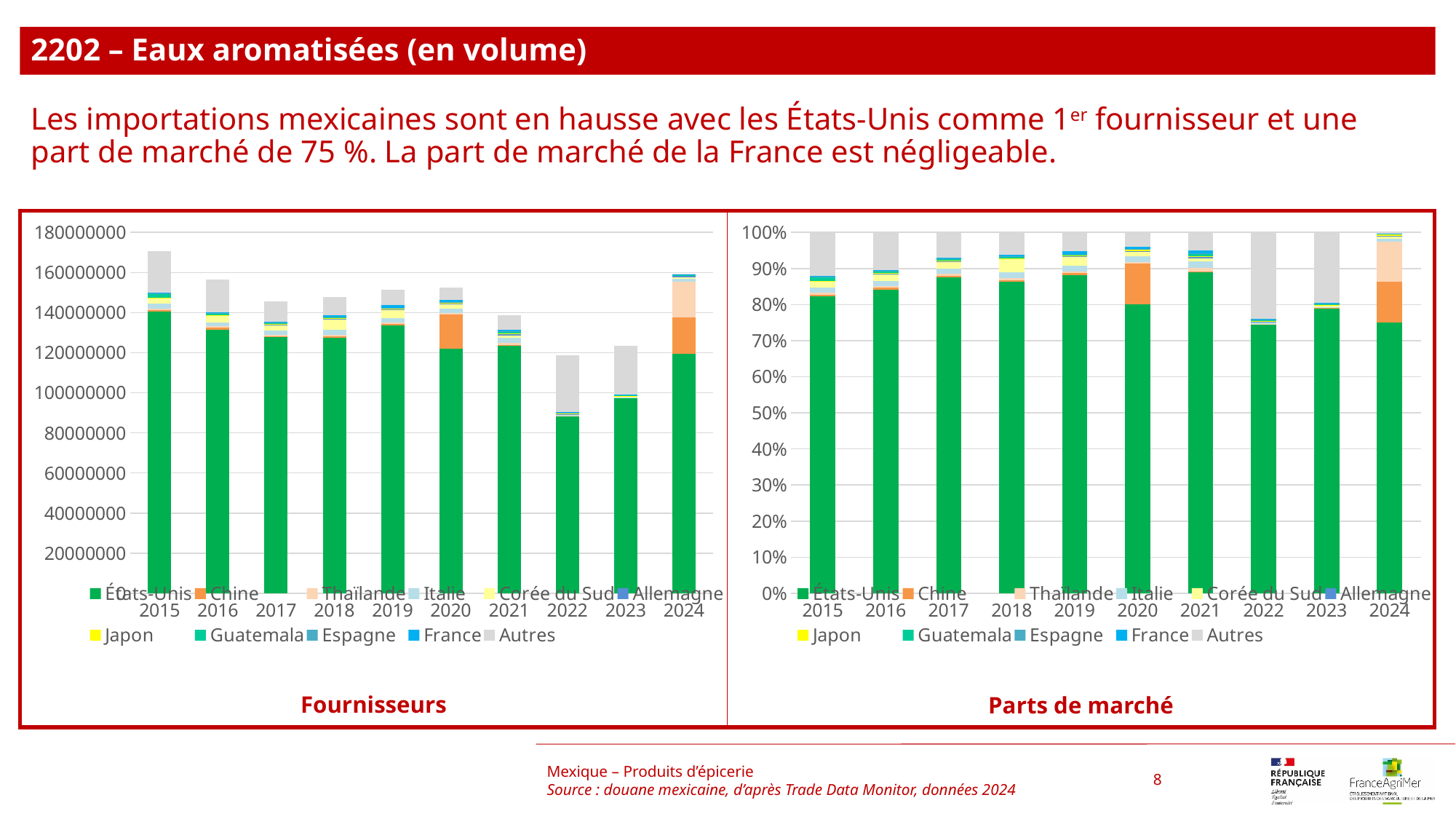
In the 'Parts de marché' chart, which series occupies the largest share of every bar? États-Unis In the 'Fournisseurs' chart, which year has the highest total bar? 2015 What kind of chart is the 'Fournisseurs' chart on the left? stacked bar chart How many series does the legend of the 'Fournisseurs' chart list? 11 In the 'Fournisseurs' chart, which total bar is larger, 2015 or 2022? 2015 In the 'Fournisseurs' chart, is the value for États-Unis in 2015 greater or less than 120000000? greater In the 'Fournisseurs' chart, is the value for États-Unis in 2022 greater or less than 100000000? less In the 'Fournisseurs' chart, which year has the lowest total bar? 2022 What is the title printed under the right-hand chart? Parts de marché In the 'Parts de marché' chart, is the share of États-Unis in 2021 greater or less than 80%? greater How many years are shown on the x axis of the 'Parts de marché' chart? 10